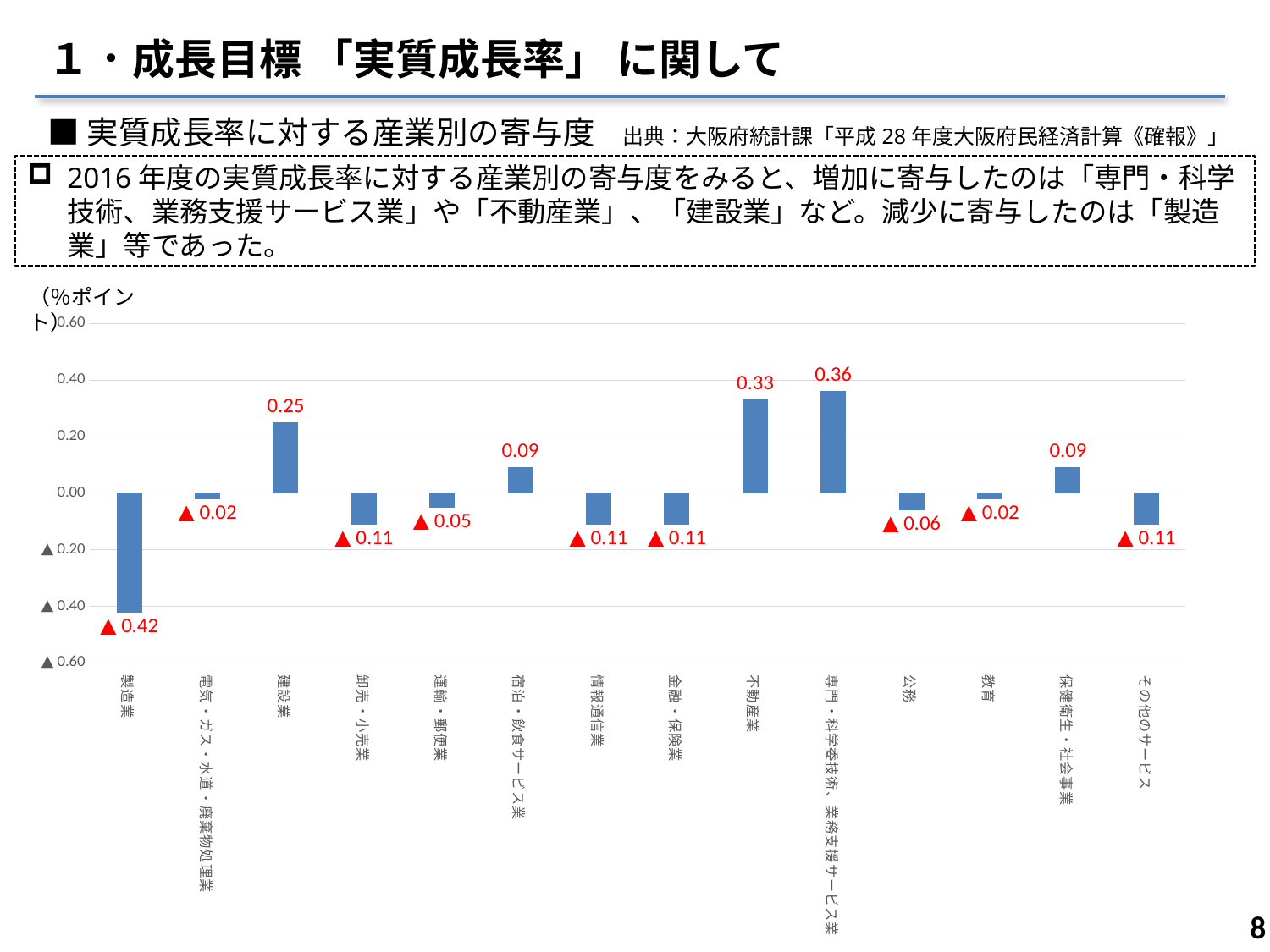
What is the value for 建設業? 0.25 What unit is shown for the y axis of the chart? %ポイント How many industries are shown on the x axis? 14 What is the value for 不動産業? 0.33 Which industry has the lowest value? 製造業 What is the difference between the values for 専門・科学委技術、業務支援サービス業 and 不動産業? 0.03 What is the value for 製造業? ▲ 0.42 What kind of chart is shown on the slide? bar chart Which industry has the highest value? 専門・科学委技術、業務支援サービス業 Is the value for 製造業 greater or less than ▲ 0.20? less What is the value for 公務? ▲ 0.06 Which is larger, the value for 建設業 or the value for 宿泊・飲食サービス業? 建設業